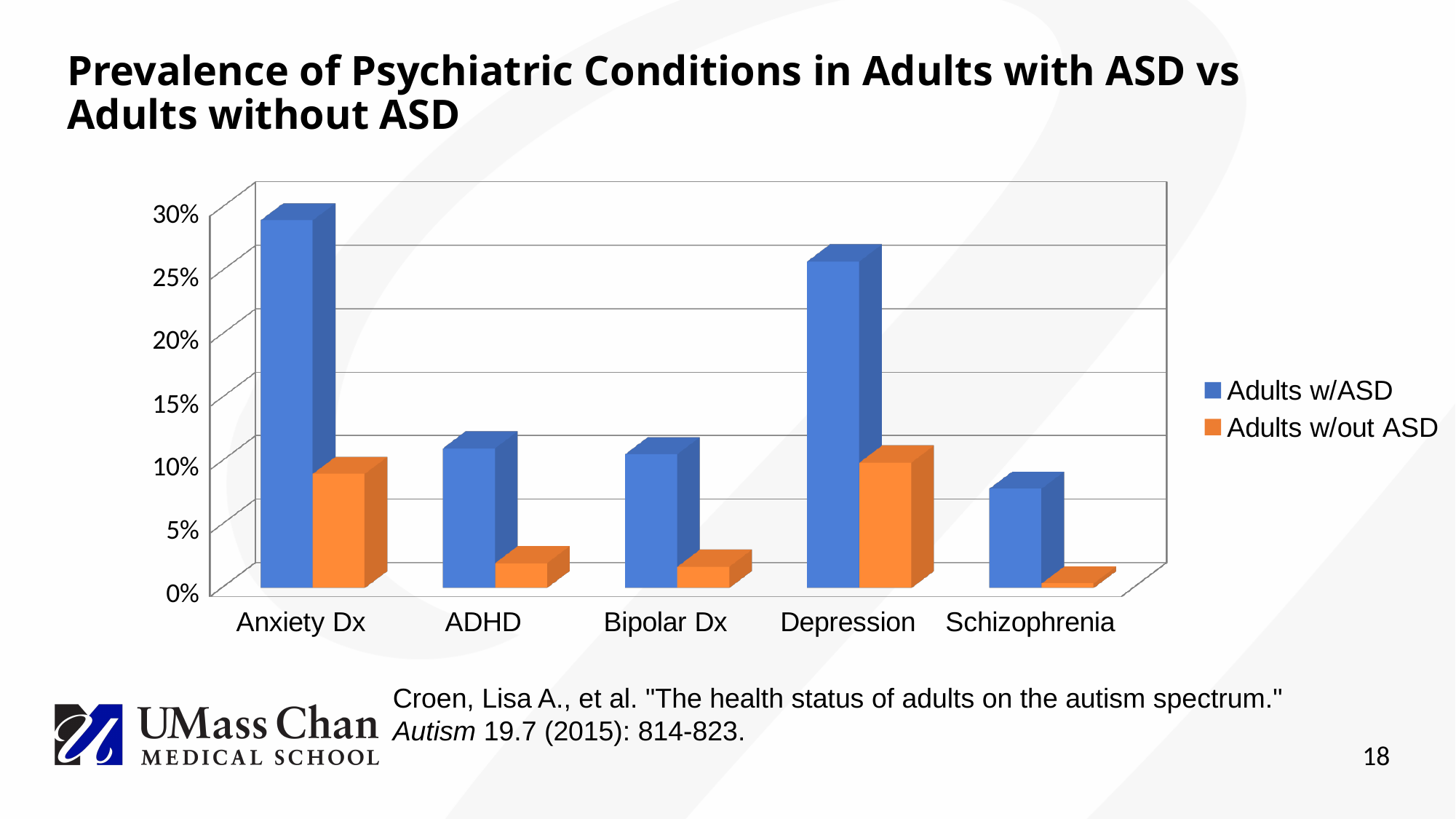
Which condition has the highest prevalence among Adults w/ASD? Anxiety Dx Is the value for ADHD among Adults w/out ASD greater or less than 5%? less What kind of chart is shown on the slide? Bar chart Is the value for Depression among Adults w/ASD greater or less than 20%? greater Which condition has the lowest prevalence among Adults w/out ASD? Schizophrenia Which colour represents Adults w/out ASD in the legend? Orange Is the value for Anxiety Dx among Adults w/ASD greater or less than 25%? greater How many psychiatric conditions are shown on the x axis? 5 Which condition has the lowest prevalence among Adults w/ASD? Schizophrenia How many series does the legend list? 2 Among Adults w/ASD, which is larger: the value for Anxiety Dx or the value for Depression? Anxiety Dx